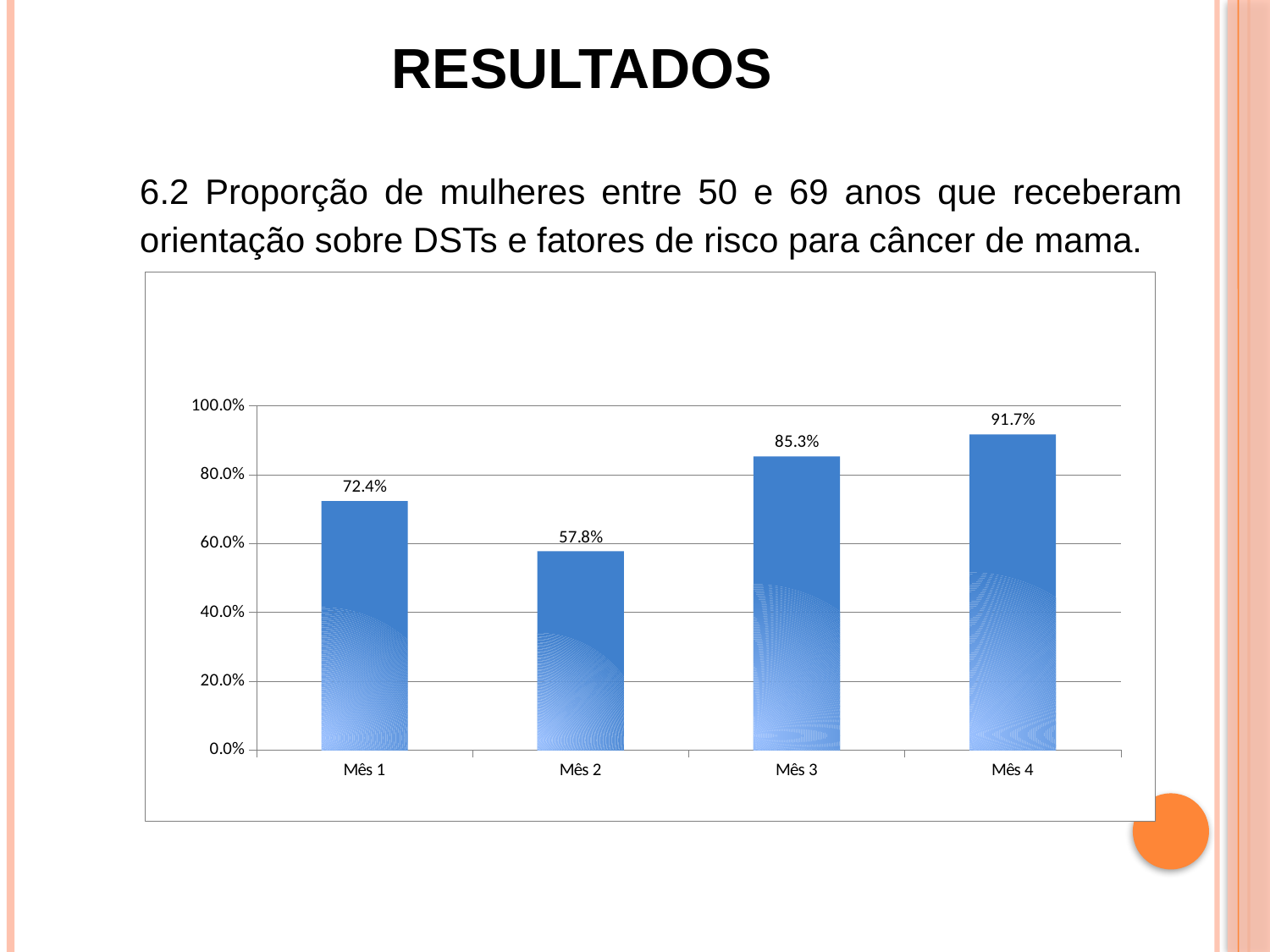
What is the difference between the values for Mês 4 and Mês 1? 19.3% What is the value for Mês 1? 72.4% Which is larger, the value for Mês 1 or the value for Mês 3? Mês 3 Which month has the lowest value? Mês 2 What kind of chart is shown on the slide? bar chart What is the value for Mês 3? 85.3% Is the value for Mês 2 greater or less than 60.0%? less What is the value for Mês 4? 91.7% How many months are shown on the x axis? 4 Which month has the highest value? Mês 4 What is the difference between the values for Mês 3 and Mês 2? 27.5% What is the value for Mês 2? 57.8%